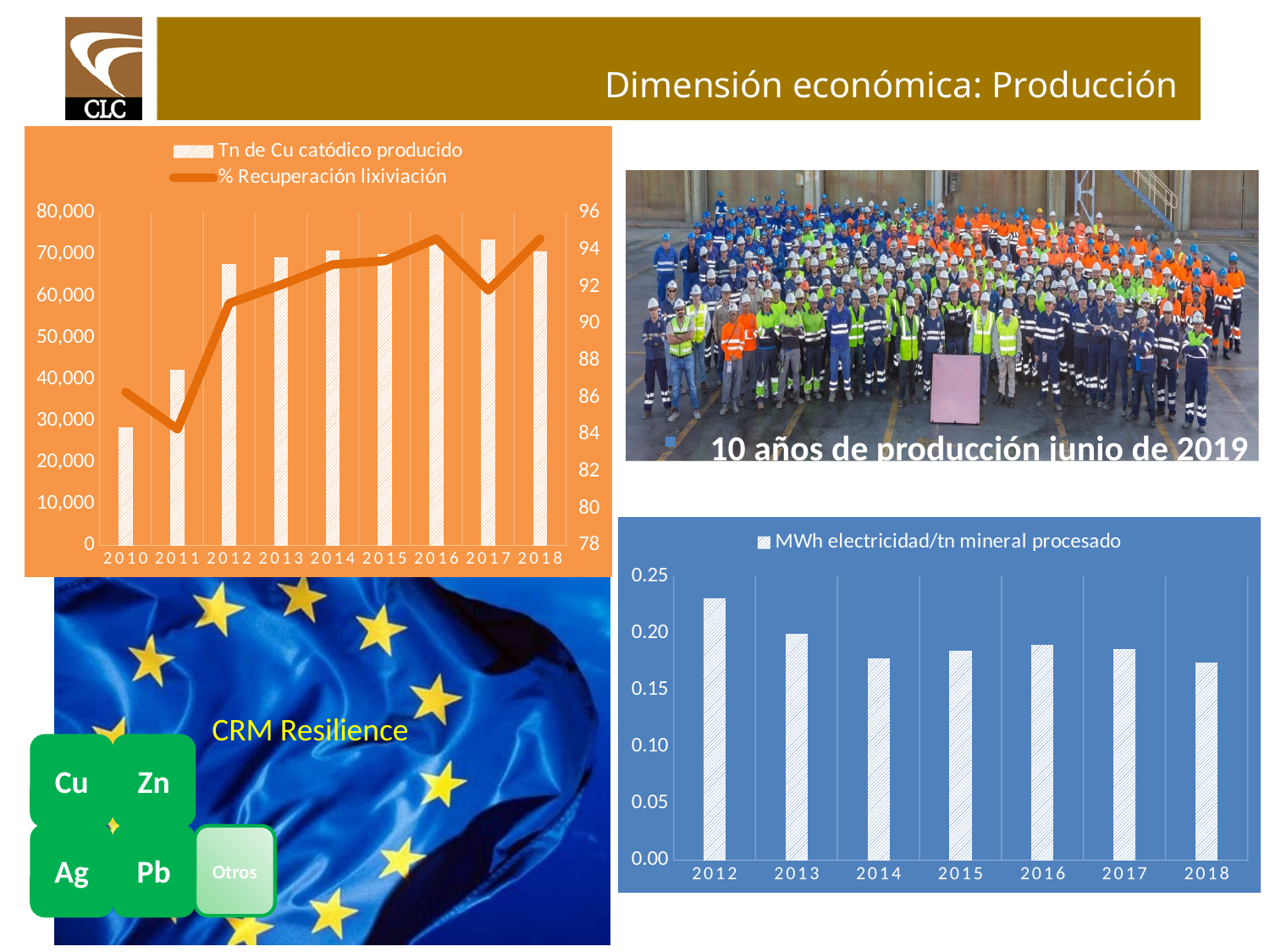
In the bottom-right chart (MWh electricidad/tn mineral procesado), which year has the highest value? 2012 In the top-left chart, how many series does the legend list? 2 In the bottom-right chart (MWh electricidad/tn mineral procesado), how many years are shown on the x axis? 7 In the top-left chart, which year has the lowest bar for Tn de Cu catódico producido? 2010 In the top-left chart, how many years are shown on the x axis? 9 In the bottom-right chart (MWh electricidad/tn mineral procesado), is the value for 2018 greater or less than 0.20? less In the top-left chart, is the % Recuperación lixiviación value for 2016 greater or less than 92? greater In the top-left chart, in which year is the % Recuperación lixiviación line at its lowest point? 2011 What kind of chart is the bottom-right chart titled MWh electricidad/tn mineral procesado? bar chart In the top-left chart, is the Tn de Cu catódico producido value for 2012 greater or less than 60,000? greater In the top-left chart, which is larger, the Tn de Cu catódico producido bar for 2010 or for 2012? 2012